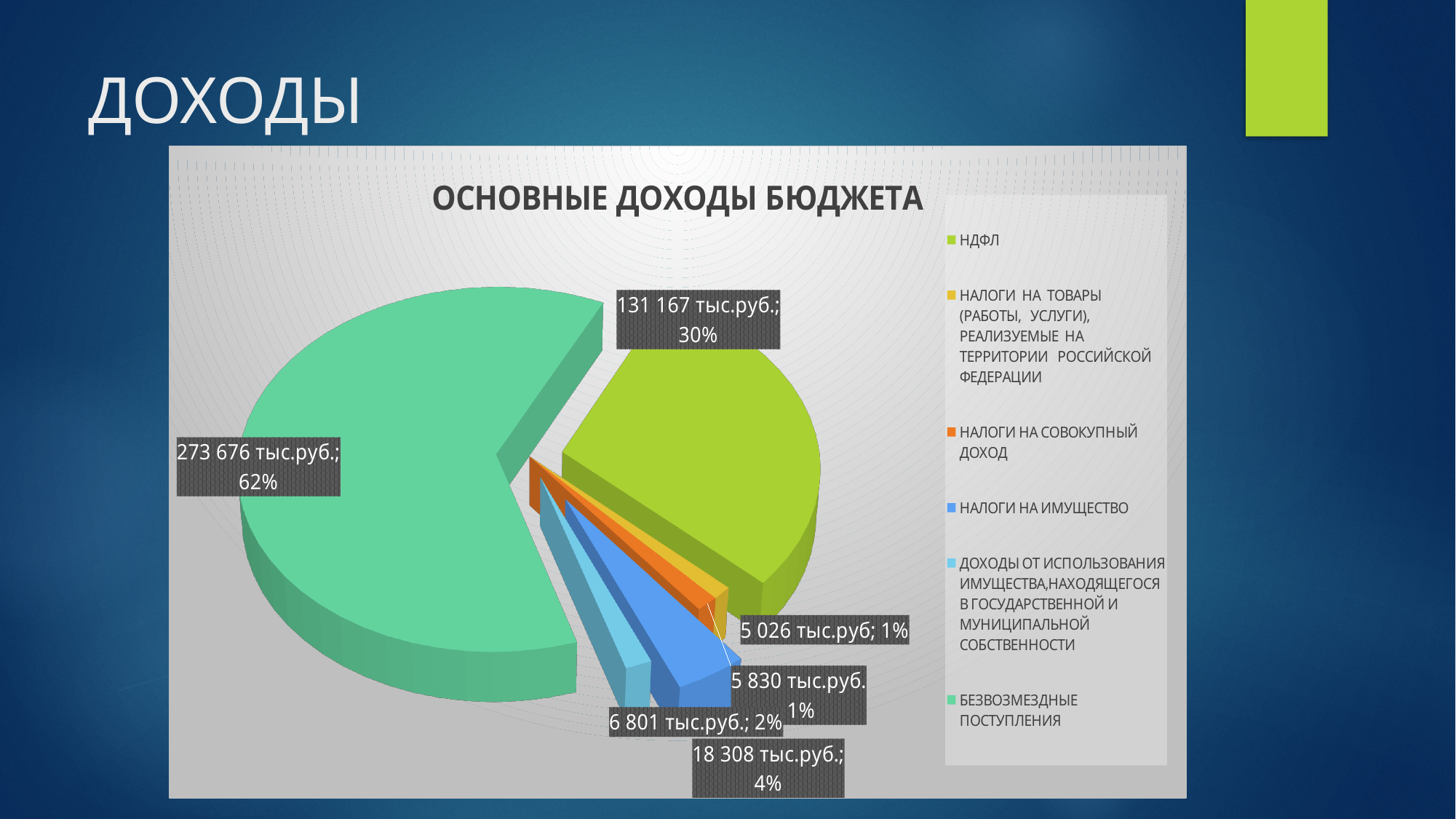
What is the combined share of НДФЛ and БЕЗВОЗМЕЗДНЫЕ ПОСТУПЛЕНИЯ? 92% What share of the pie does БЕЗВОЗМЕЗДНЫЕ ПОСТУПЛЕНИЯ account for? 62% What value is shown for НАЛОГИ НА ИМУЩЕСТВО? 18 308 тыс.руб. Which category has the largest slice of the pie? БЕЗВОЗМЕЗДНЫЕ ПОСТУПЛЕНИЯ What value is shown for БЕЗВОЗМЕЗДНЫЕ ПОСТУПЛЕНИЯ? 273 676 тыс.руб. What kind of chart is shown on the slide? pie chart Which is larger, НДФЛ or БЕЗВОЗМЕЗДНЫЕ ПОСТУПЛЕНИЯ? БЕЗВОЗМЕЗДНЫЕ ПОСТУПЛЕНИЯ How many categories does the legend of the pie chart list? 6 What value is shown for НДФЛ? 131 167 тыс.руб. What share of the pie does НДФЛ account for? 30% What is the difference between БЕЗВОЗМЕЗДНЫЕ ПОСТУПЛЕНИЯ and НДФЛ in тыс.руб.? 142 509 тыс.руб. What is the title of the chart? ОСНОВНЫЕ ДОХОДЫ БЮДЖЕТА